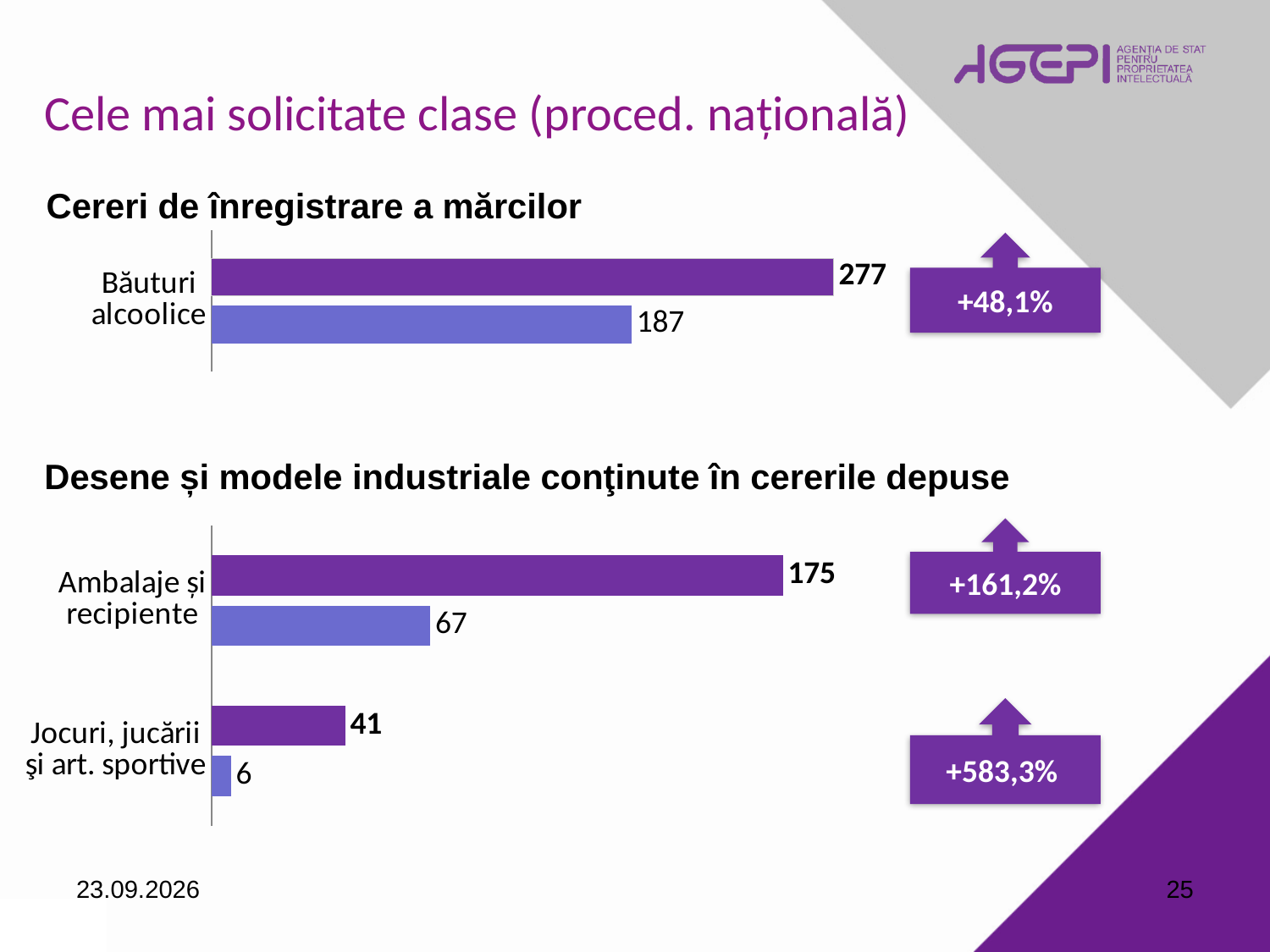
In the chart 'Desene și modele industriale conţinute în cererile depuse', what is the difference between the dark purple and light purple bars for Ambalaje și recipiente? 108 In the chart 'Desene și modele industriale conţinute în cererile depuse', what is the value of the dark purple bar for Ambalaje și recipiente? 175 In the chart 'Desene și modele industriale conţinute în cererile depuse', what is the value of the dark purple bar for Jocuri, jucării şi art. sportive? 41 In the chart 'Cereri de înregistrare a mărcilor', what is the value of the dark purple bar for Băuturi alcoolice? 277 In the chart 'Desene și modele industriale conţinute în cererile depuse', how many categories are shown? 2 In the chart 'Cereri de înregistrare a mărcilor', what is the difference between the dark purple bar and the light purple bar for Băuturi alcoolice? 90 In the chart 'Cereri de înregistrare a mărcilor', what is the value of the light purple bar for Băuturi alcoolice? 187 What type of chart is 'Cereri de înregistrare a mărcilor'? Bar chart What percentage change is shown next to the 'Cereri de înregistrare a mărcilor' chart for Băuturi alcoolice? +48,1% In the chart 'Desene și modele industriale conţinute în cererile depuse', which category has the highest dark purple bar? Ambalaje și recipiente In the chart 'Desene și modele industriale conţinute în cererile depuse', what is the value of the light purple bar for Jocuri, jucării şi art. sportive? 6 In the chart 'Desene și modele industriale conţinute în cererile depuse', which category has the lowest light purple bar? Jocuri, jucării şi art. sportive